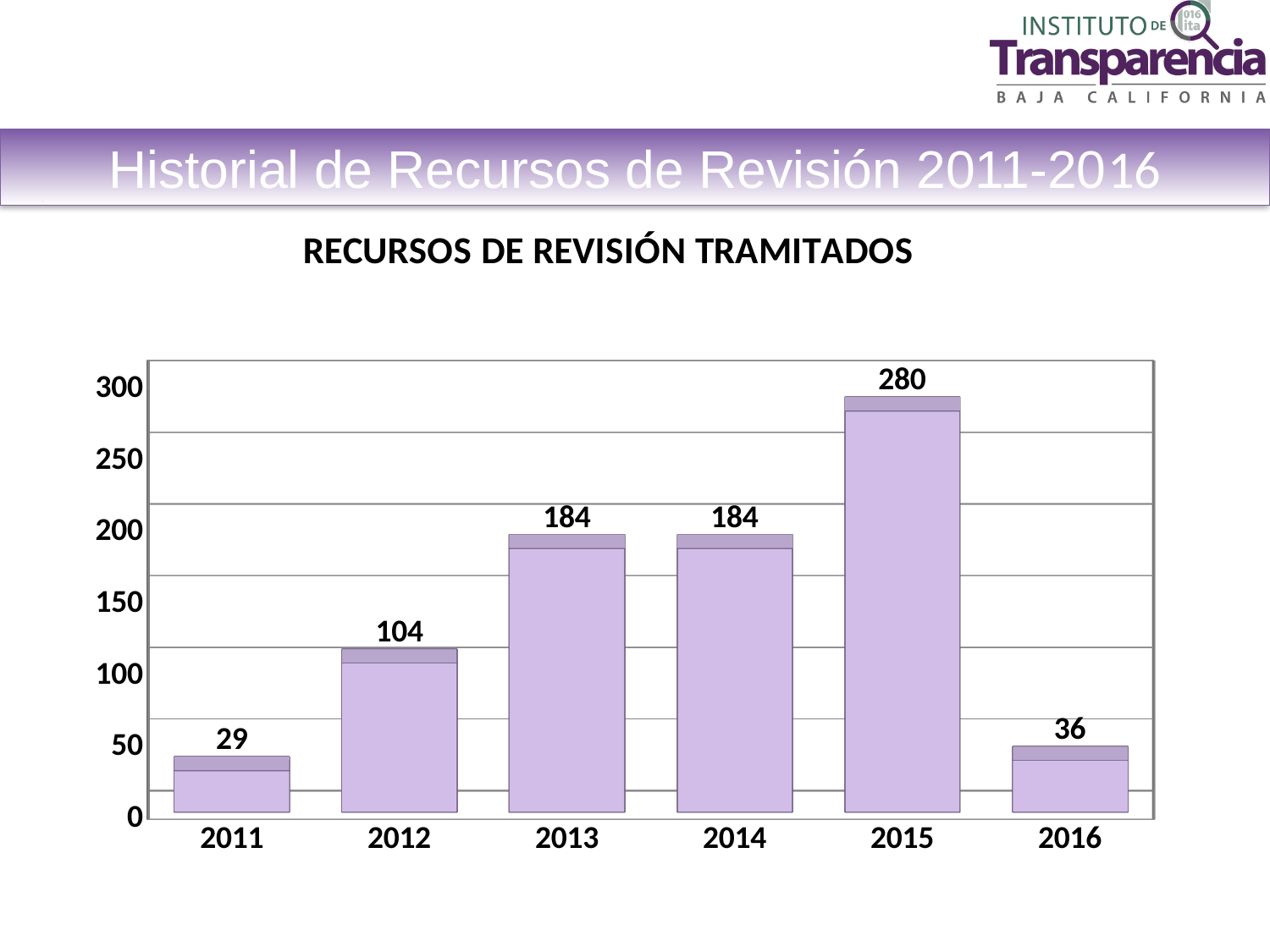
Which is larger, the value for 2012 or the value for 2016? 2012 What is the value for 2012? 104 What is the difference between the values for 2012 and 2011? 75 What kind of chart is this? Bar chart Which year has the highest value? 2015 What is the value for 2015? 280 Which year has the lowest value? 2011 What is the title of the chart? RECURSOS DE REVISIÓN TRAMITADOS What is the value for 2011? 29 How many years are shown on the x axis? 6 What is the difference between the values for 2015 and 2014? 96 What is the value for 2016? 36